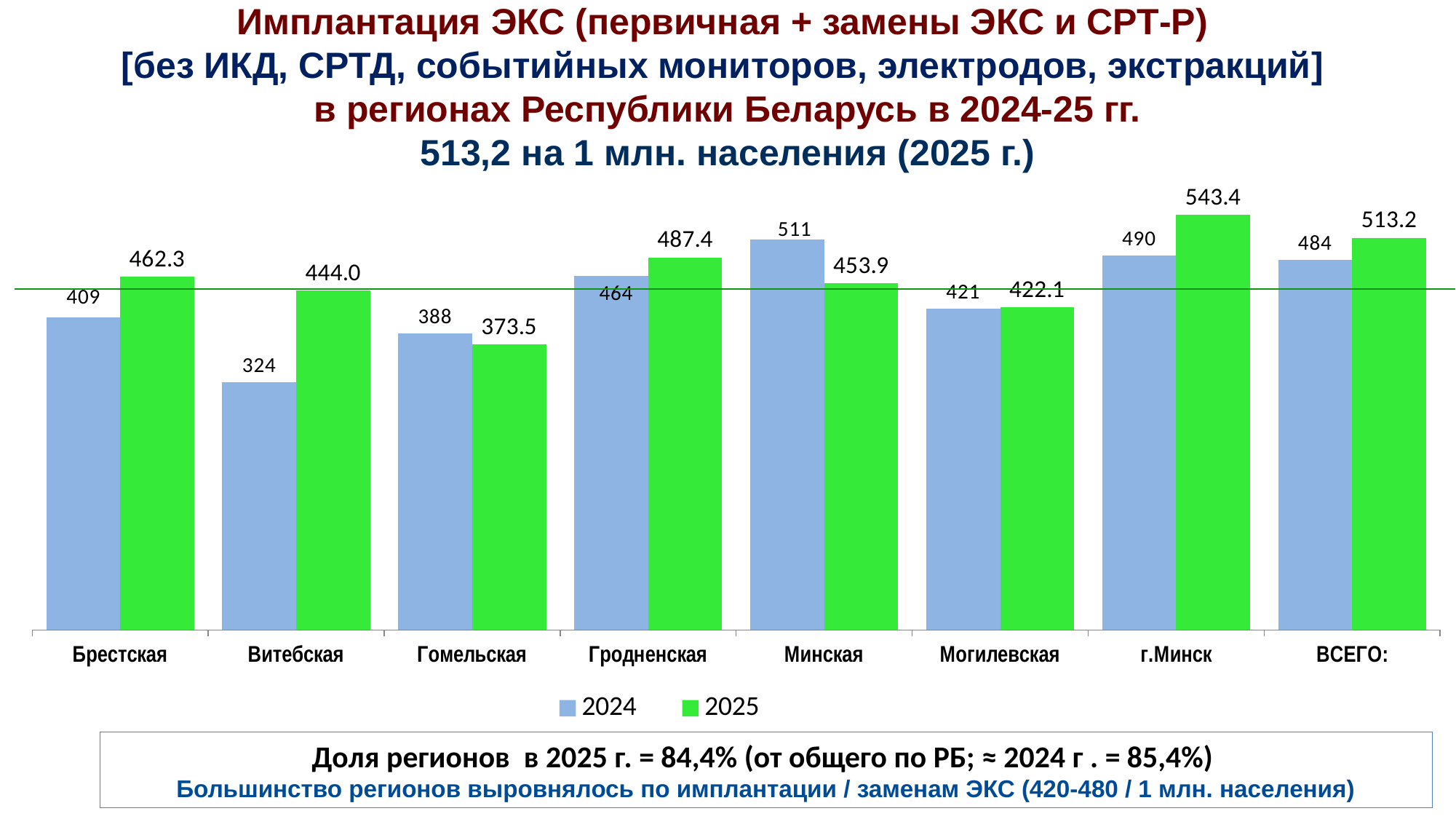
What is the difference between the 2024 and 2025 values for Минская? 57.1 For Гомельская, which series has the larger value, 2024 or 2025? 2024 What is the value for Брестская in the 2025 series? 462.3 What is the value for ВСЕГО: in the 2025 series? 513.2 Which category has the highest value in the 2025 series? г.Минск How many series does the legend list? 2 How many categories are shown on the x axis? 8 Which category has the highest value in the 2024 series? Минская What is the value for Витебская in the 2024 series? 324 What is the difference between the 2025 and 2024 values for Витебская? 120 Which category has the lowest value in the 2025 series? Гомельская Which category has the lowest value in the 2024 series? Витебская